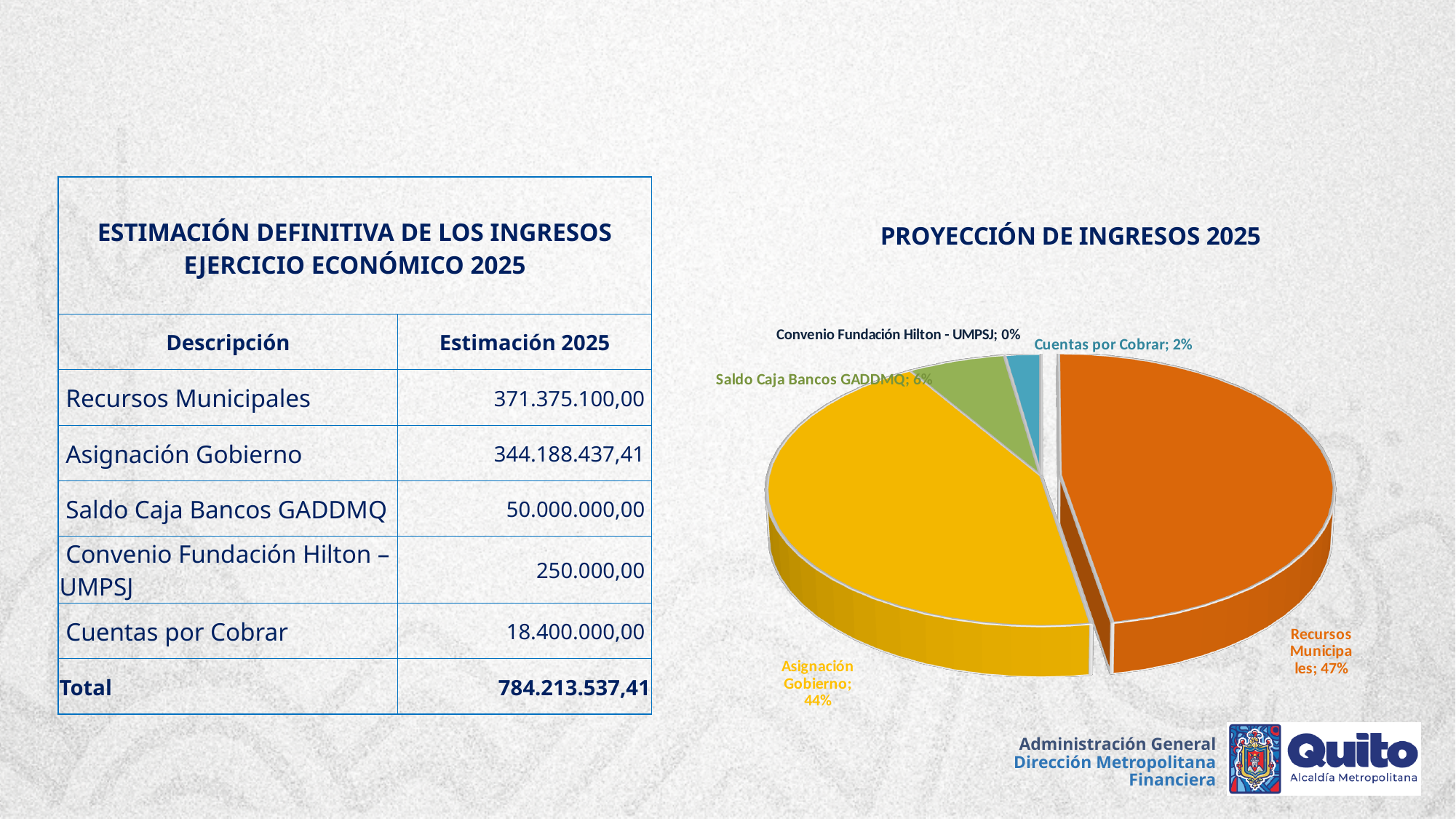
How many slices does the pie chart have? 5 What type of chart is shown on the slide? Pie chart What share of the pie does Asignación Gobierno represent? 44% Which is larger, the share for Saldo Caja Bancos GADDMQ or the share for Cuentas por Cobrar? Saldo Caja Bancos GADDMQ Which category has the smallest slice of the pie? Convenio Fundación Hilton - UMPSJ What is the difference in percentage points between Recursos Municipales and Asignación Gobierno? 3 percentage points What percentage is shown for Cuentas por Cobrar? 2% Which category has the largest slice of the pie? Recursos Municipales What is the title of the chart? PROYECCIÓN DE INGRESOS 2025 What share of the pie does Recursos Municipales represent? 47% What percentage is shown for Convenio Fundación Hilton - UMPSJ? 0% What percentage is shown for Saldo Caja Bancos GADDMQ? 6%